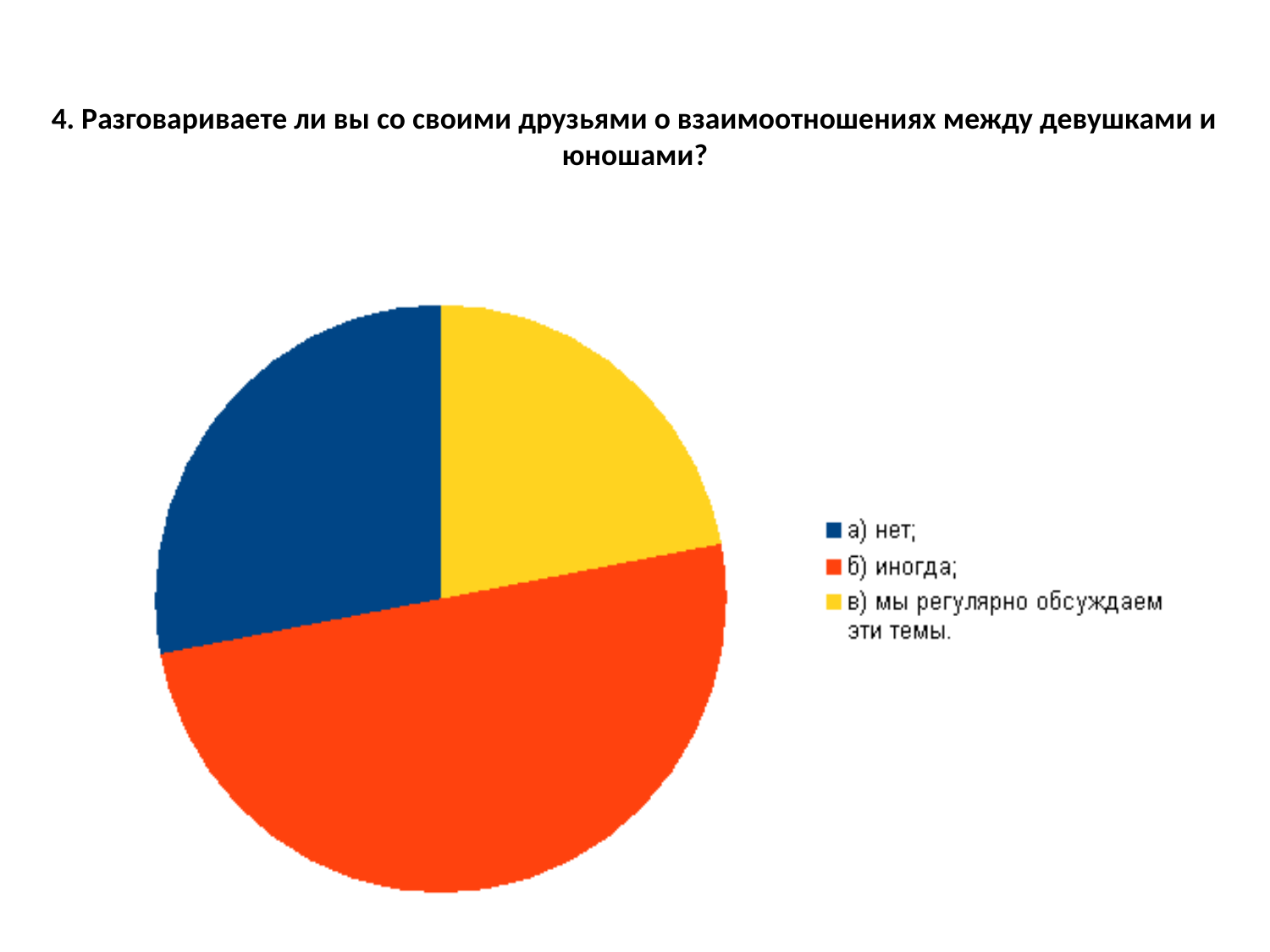
What colour is the slice for "а) нет" in the pie chart? blue Which slice is larger: "в) мы регулярно обсуждаем эти темы" or "б) иногда"? б) иногда Which answer option has the largest slice in the pie chart? б) иногда What colour is the slice for "в) мы регулярно обсуждаем эти темы"? yellow Which slice is larger: "б) иногда" or "а) нет"? б) иногда How many slices does the pie chart have? 3 What kind of chart is shown on the slide? pie chart How many entries does the legend of the pie chart list? 3